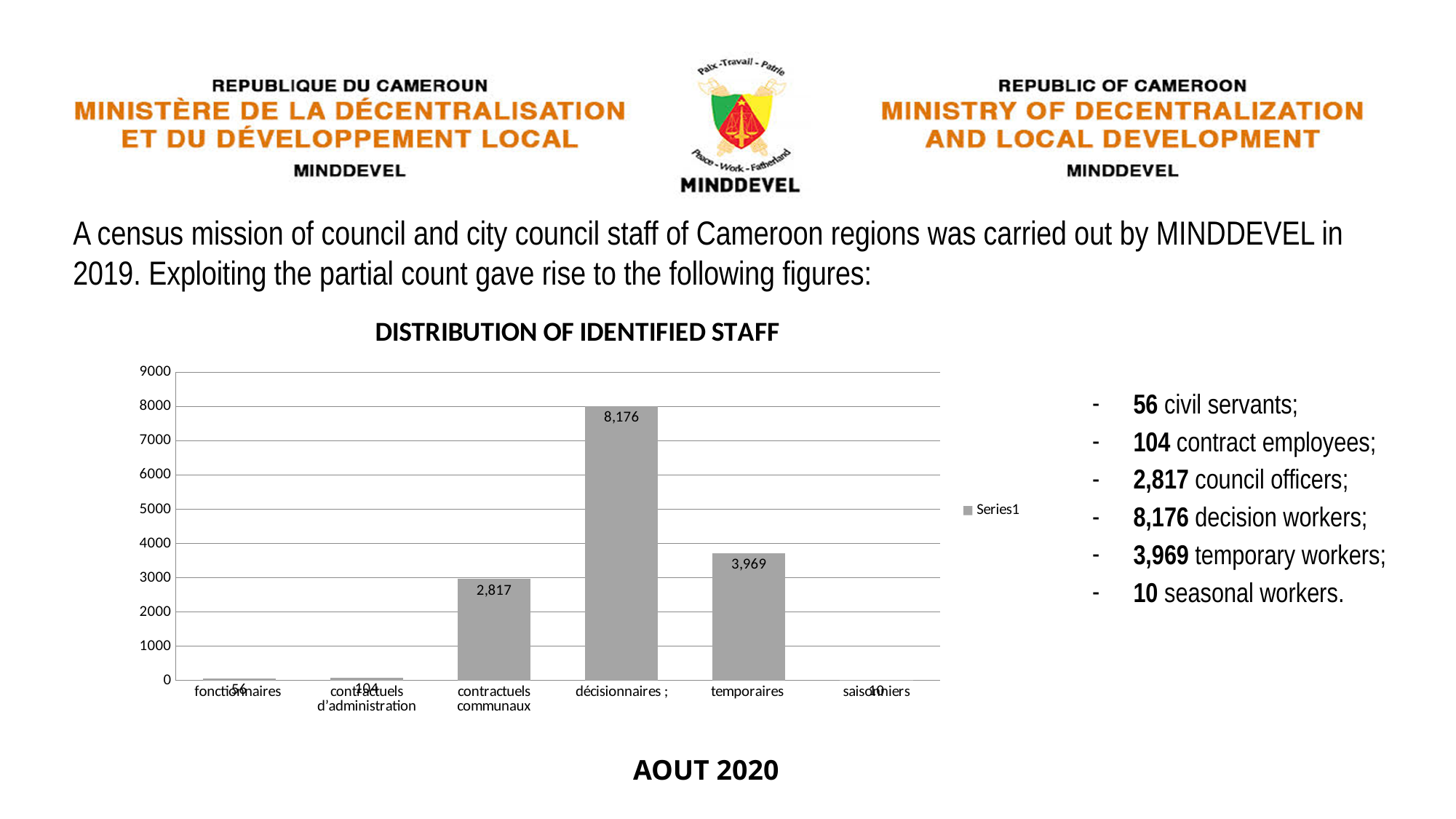
What is the value for contractuels communaux? 2,817 What is the value for temporaires? 3,969 Which category has the highest value? décisionnaires Which is larger, the value for contractuels communaux or the value for temporaires? temporaires What is the value for décisionnaires? 8,176 What type of chart is shown on the slide? bar chart What is the difference between the values for décisionnaires and temporaires? 4,207 How many series does the legend list? 1 What is the title of the chart? DISTRIBUTION OF IDENTIFIED STAFF How many categories are shown on the x axis? 6 Which category has the lowest value? saisonniers